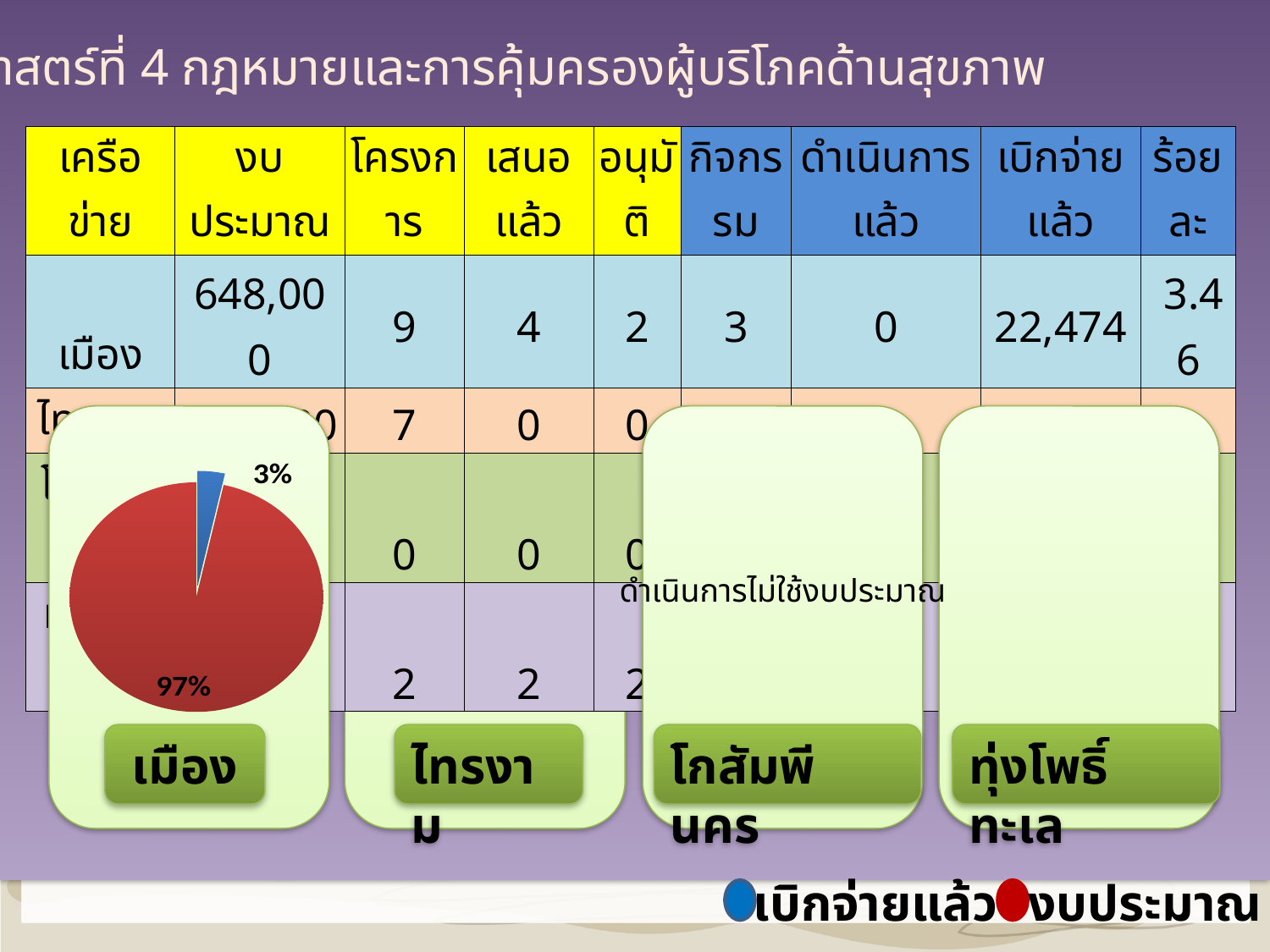
In the pie chart in the เมือง box, what percentage is shown for the blue slice (เบิกจ่ายแล้ว)? 3% In the pie chart in the เมือง box, what is the difference in percentage points between the งบประมาณ slice and the เบิกจ่ายแล้ว slice? 94 In the pie chart in the เมือง box, which slice is the smallest? เบิกจ่ายแล้ว In the pie chart in the เมือง box, which is larger: the เบิกจ่ายแล้ว slice or the งบประมาณ slice? งบประมาณ What colour represents งบประมาณ in the pie chart legend? red In the pie chart in the เมือง box, what share of the pie does the เบิกจ่ายแล้ว slice take? 3% In the pie chart in the เมือง box, which slice is the largest? งบประมาณ What colour represents เบิกจ่ายแล้ว in the pie chart legend? blue How many entries does the legend at the bottom of the slide list for the pie chart? 2 What kind of chart is shown in the เมือง box? pie chart In the pie chart in the เมือง box, what percentage is shown for the red slice (งบประมาณ)? 97% In the pie chart in the เมือง box, how many slices are there? 2